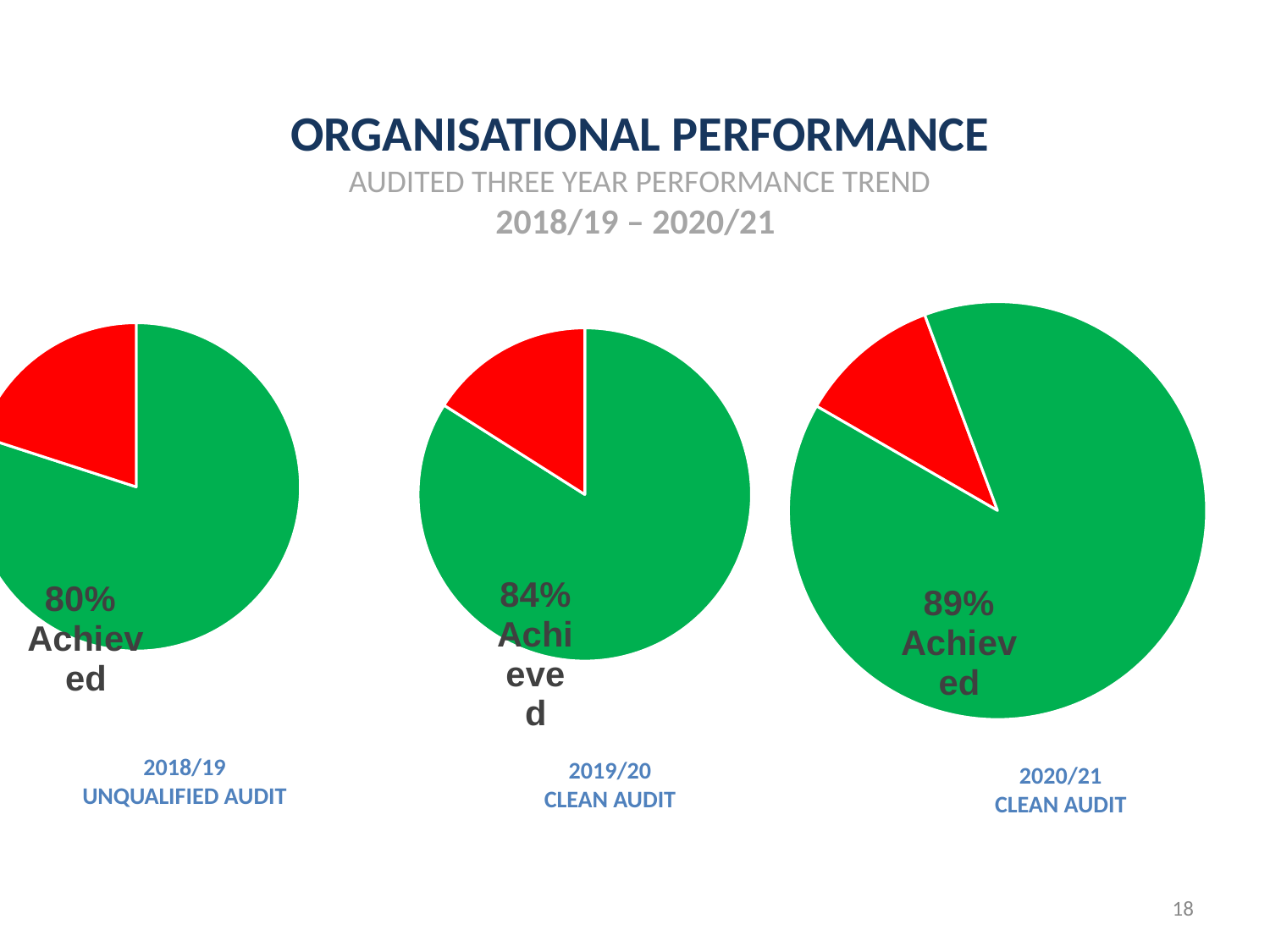
Across the three pie charts, which year shows the lowest percentage achieved? 2018/19 What kind of chart is used to show the performance for each year? Pie chart What is the difference between the 2019/20 and 2018/19 achieved percentages? 4 percentage points Does the achieved percentage rise or fall from 2018/19 to 2020/21? Rise How many pie charts are shown on the slide? 3 In the 2018/19 pie chart, what percentage was achieved? 80% What audit outcome is labelled under the 2018/19 pie chart? Unqualified audit By how many percentage points does the 2020/21 achieved figure exceed the 2018/19 achieved figure? 9 percentage points Which is larger, the achieved percentage for 2019/20 or for 2020/21? 2020/21 Across the three pie charts, which year shows the highest percentage achieved? 2020/21 In the 2019/20 pie chart, what percentage was achieved? 84% In the 2020/21 pie chart, what percentage was achieved? 89%